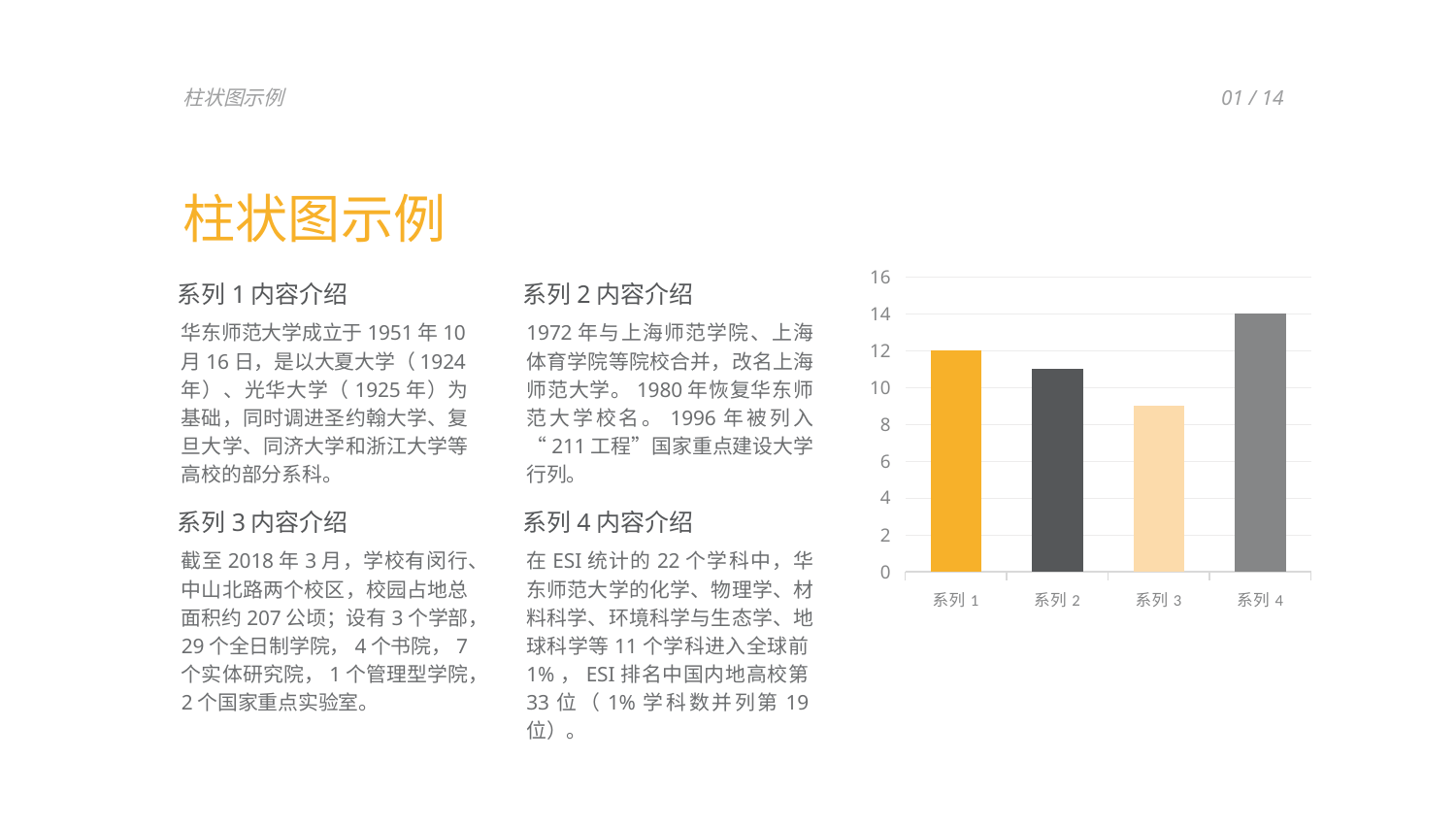
Is the value for 系列 3 greater or less than 10? less Which category has the lowest bar? 系列 3 What is the value for 系列 1? 12 What is the difference between the values for 系列 4 and 系列 1? 2 How many bars (categories) does the chart show? 4 Is the value for 系列 2 greater or less than 10? greater What is the highest value shown on the vertical axis? 16 Which is larger, the value for 系列 1 or the value for 系列 2? 系列 1 What is the value for 系列 4? 14 Which category has the highest bar? 系列 4 What colour is the bar for 系列 1? orange What kind of chart is shown on the slide? bar chart